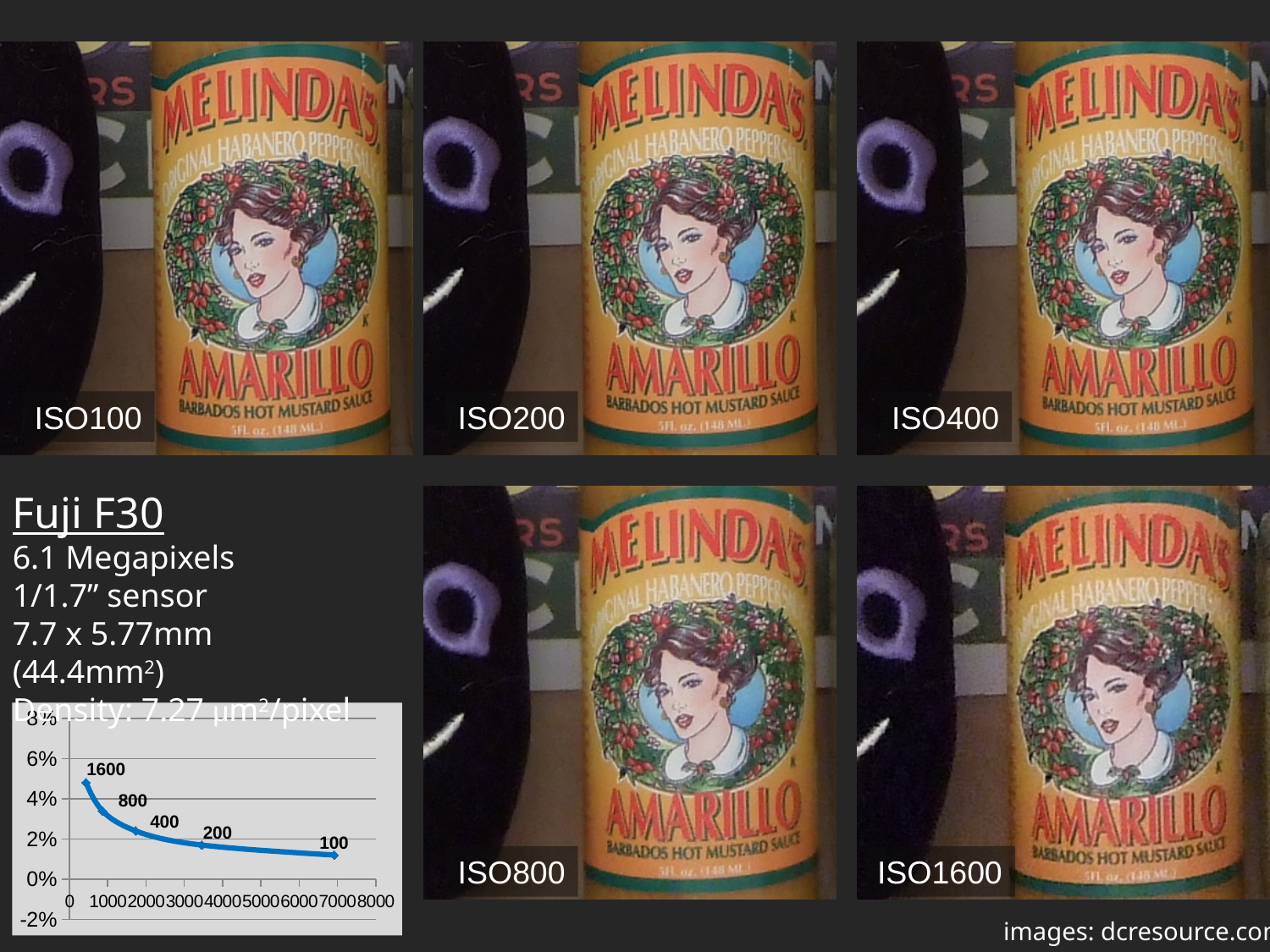
Is the value for the point labelled 100 greater or less than 2%? less Is the value for the point labelled 800 greater or less than 2%? greater Which labelled point on the line chart has the highest value? 1600 Which labelled point on the line chart has the lowest value? 100 What is the highest tick shown on the x axis of the line chart? 8000 How many data points are labelled on the line chart? 5 What kind of chart is shown on the slide? line chart Is the value for the point labelled 1600 greater or less than 4%? greater Do the values on the line chart rise or fall as you move along the x axis? fall Which has the larger value on the line chart, the point labelled 800 or the point labelled 200? 800 Which has the larger value on the line chart, the point labelled 1600 or the point labelled 100? 1600